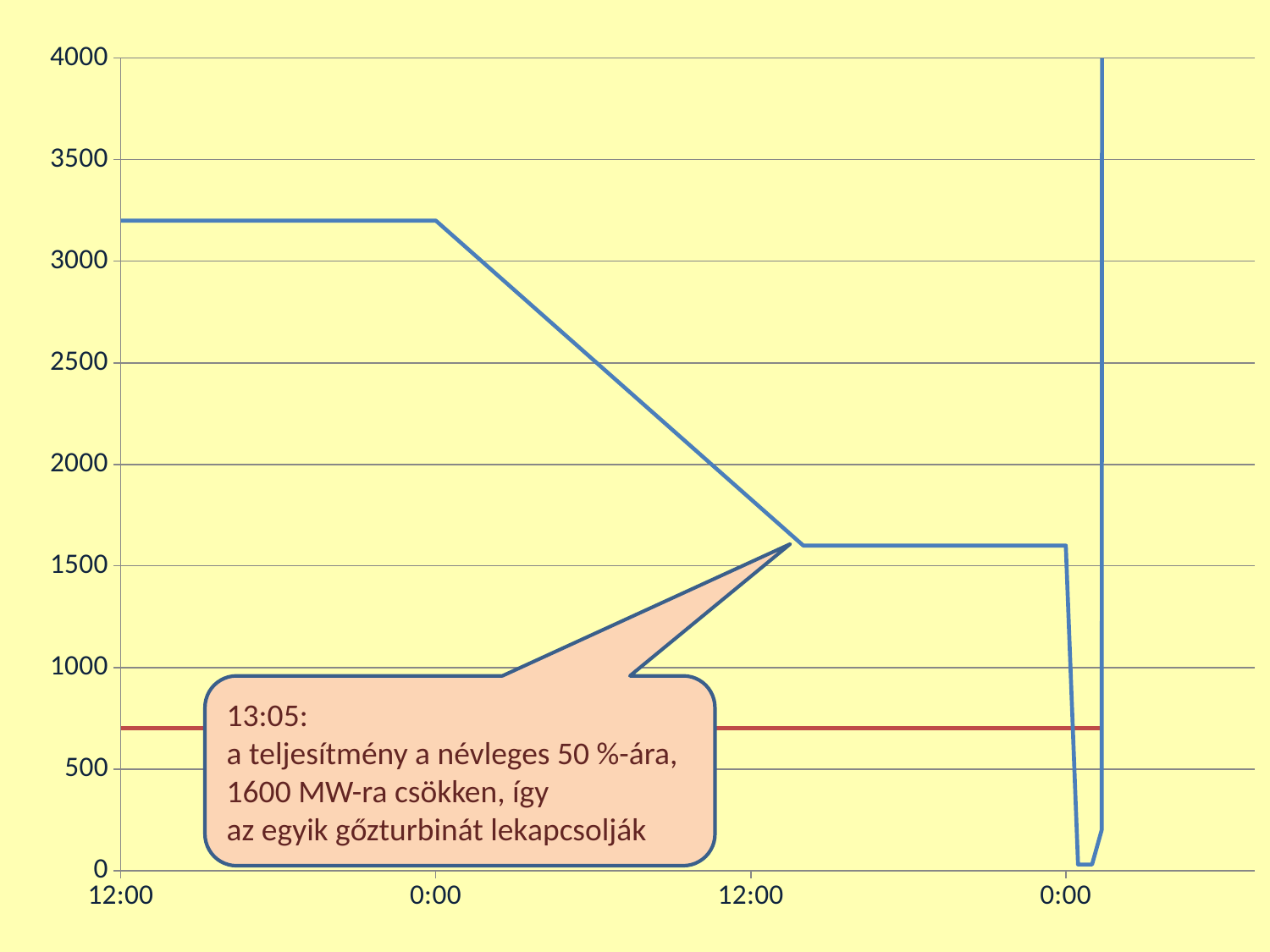
Does the blue line rise or fall between the first 0:00 tick and the second 12:00 tick? fall Is the value of the red horizontal line greater or less than 1000? less What kind of chart is shown on the slide? line chart According to the callout, to what value does the power drop at 13:05? 1600 MW How many tick labels are shown on the x axis? 4 Is the value of the blue line at the second 12:00 tick greater or less than 2000? less At what time does the callout say the power reduction to 1600 MW occurs? 13:05 At the first 12:00 tick, which line has the higher value, the blue line or the red line? the blue line What is the highest value labelled on the y axis? 4000 Is the value of the red horizontal line greater or less than 500? greater According to the callout, what percentage of the nominal power does the output fall to? 50 %